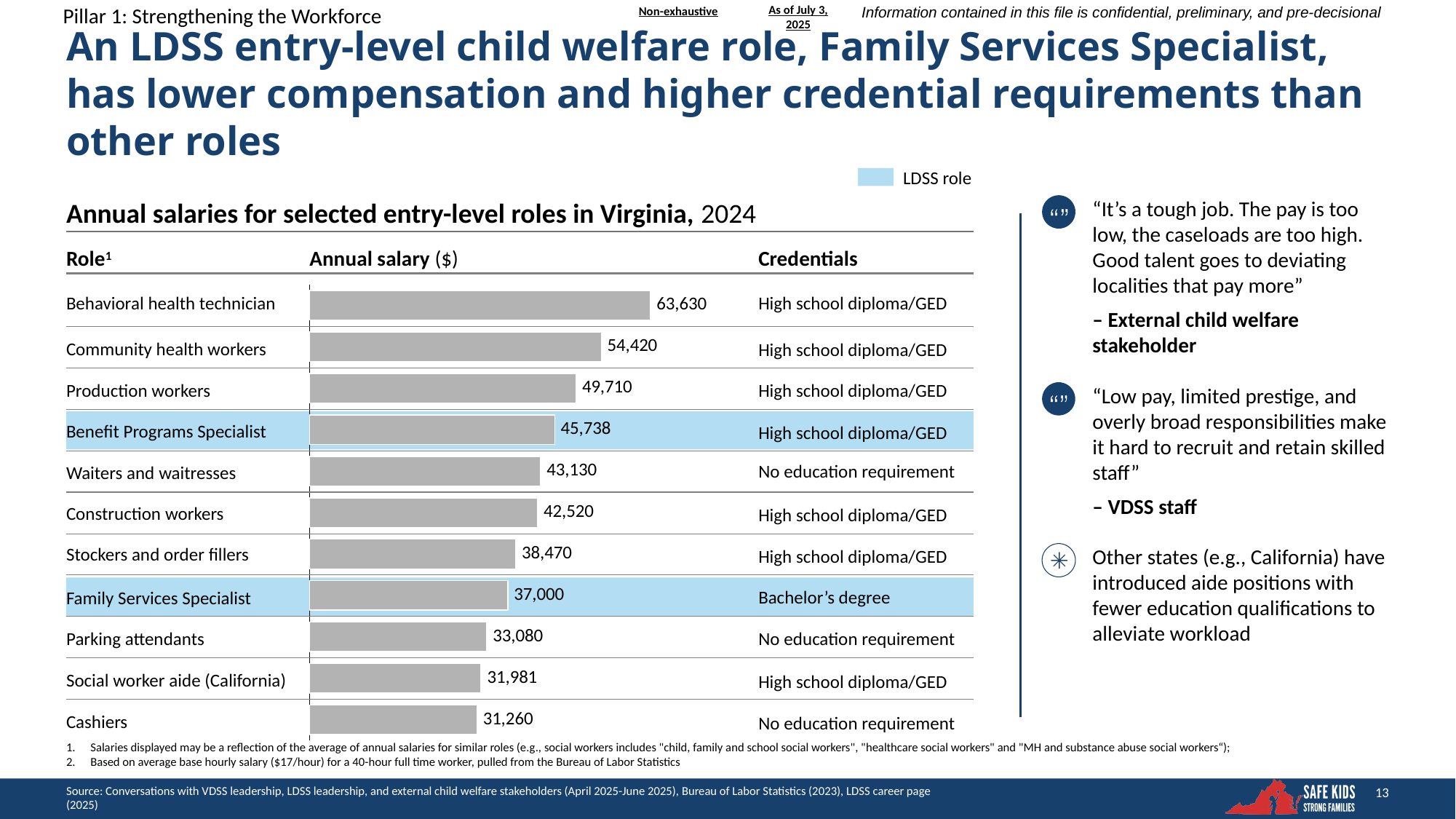
Which role has the highest annual salary in the chart? Behavioral health technician Which has a higher annual salary, Waiters and waitresses or Construction workers? Waiters and waitresses How many roles are listed in the chart? 11 What kind of chart is used to show the annual salaries? Bar chart Which role has the lowest annual salary in the chart? Cashiers What is the annual salary shown for Benefit Programs Specialist? 45,738 Which has a higher annual salary, Parking attendants or Social worker aide (California)? Parking attendants What is the annual salary shown for Family Services Specialist? 37,000 What is the difference in annual salary between Behavioral health technician and Family Services Specialist? 26,630 What does the light blue highlighting in the chart indicate, according to the legend? LDSS role What is the difference in annual salary between Benefit Programs Specialist and Family Services Specialist? 8,738 What is the annual salary shown for Social worker aide (California)? 31,981